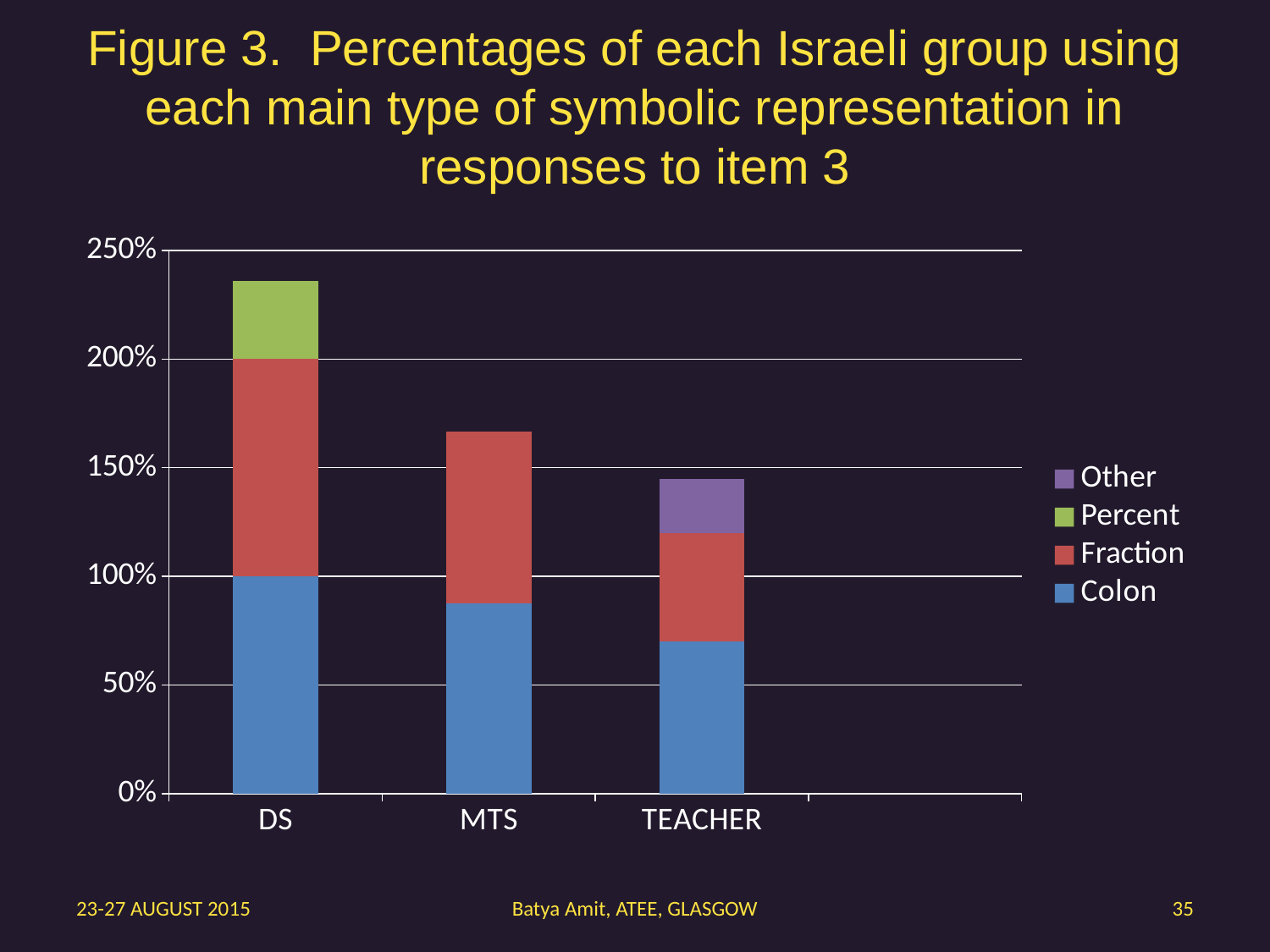
Is the total stacked value for MTS greater or less than 150%? greater Which group has the tallest stacked bar? DS How many groups are shown on the x axis of the chart? 3 Do the total stacked values rise or fall from DS to TEACHER along the x axis? fall Is the Colon value for TEACHER greater or less than 100%? less How many series does the chart legend list? 4 Which group has the shortest stacked bar? TEACHER Which group is the only one with a Percent segment in its bar? DS Is the total stacked value for TEACHER greater or less than 150%? less Which group has the larger Colon segment, DS or MTS? DS What kind of chart is shown on the slide? Stacked bar chart